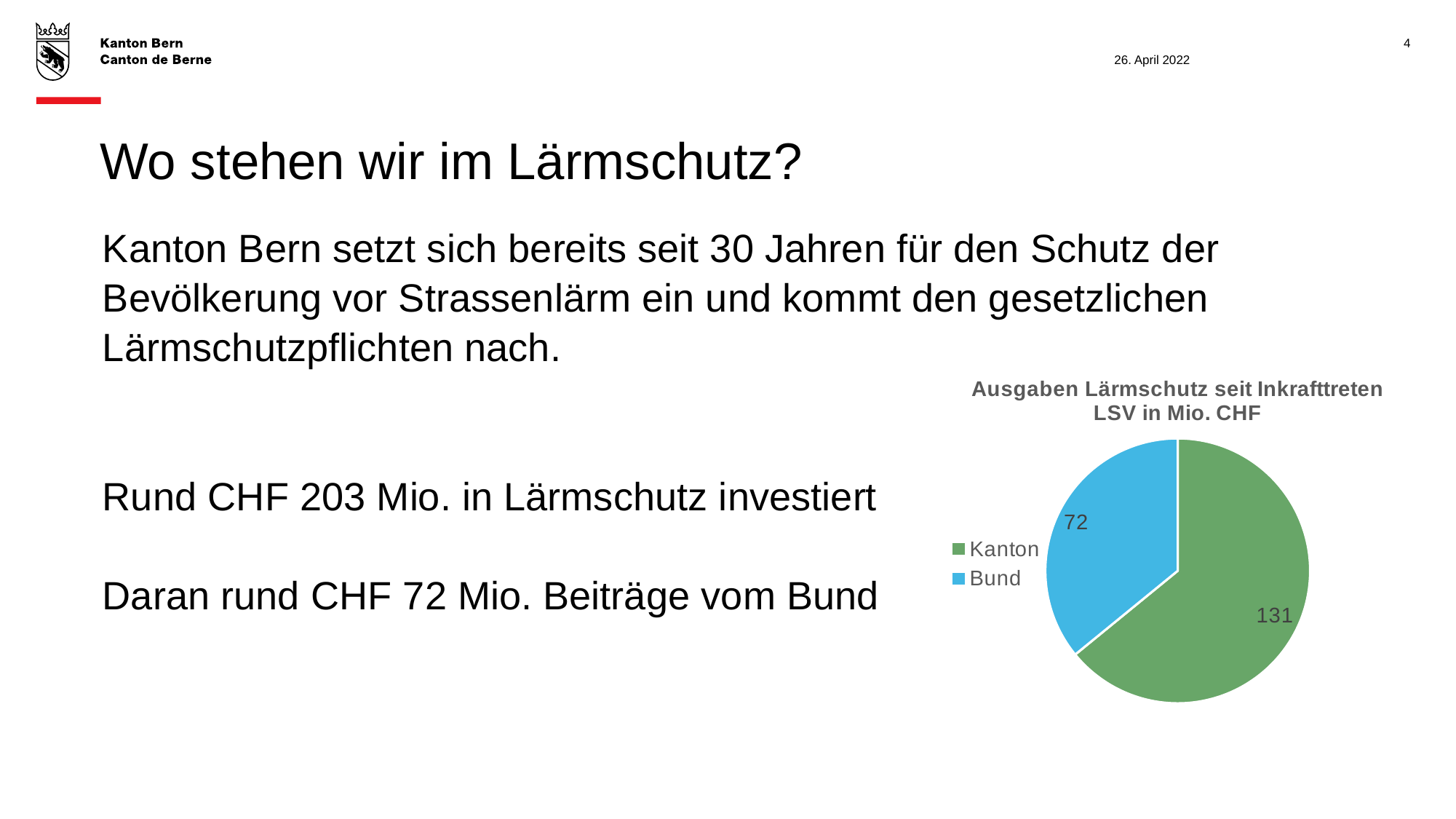
What is the total of the two slices in the pie chart? 203 What is the title of the chart on the slide? Ausgaben Lärmschutz seit Inkrafttreten LSV in Mio. CHF What is the value for Bund in the pie chart? 72 Which slice of the pie chart is the smallest? Bund Which is larger in the pie chart, Kanton or Bund? Kanton How many entries does the legend of the pie chart list? 2 How many slices does the pie chart have? 2 What is the value for Kanton in the pie chart? 131 What colour is the Bund slice in the pie chart? Blue Which slice of the pie chart is the largest? Kanton What kind of chart is shown on the slide? Pie chart What is the difference between the Kanton and Bund values in the pie chart? 59